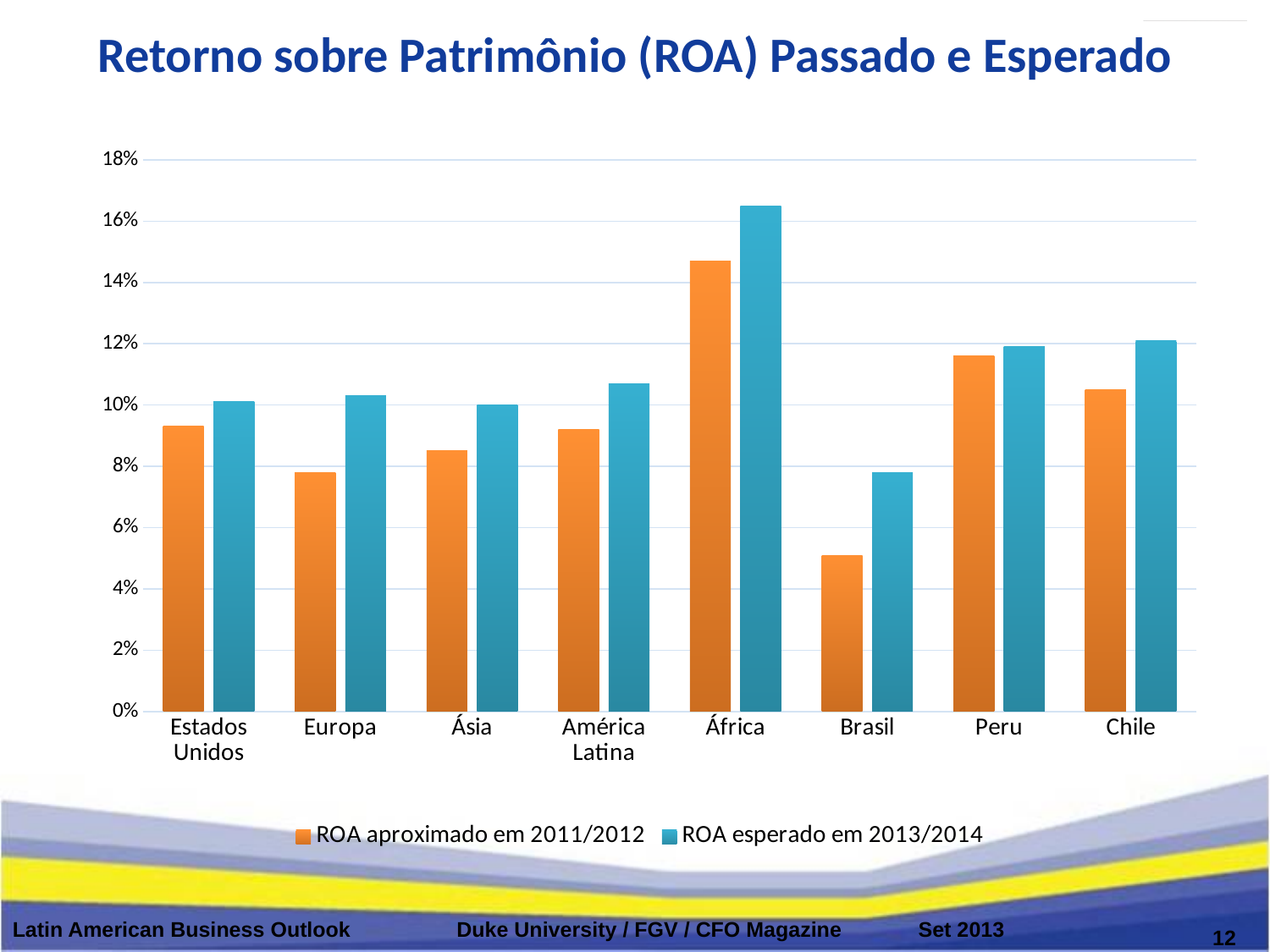
Which region has the lowest value for ROA esperado em 2013/2014? Brasil Is the value for ROA aproximado em 2011/2012 for Peru greater or less than 10%? greater Which region has the highest value for ROA aproximado em 2011/2012? África What kind of chart is shown on the slide? bar chart Which region has the lowest value for ROA aproximado em 2011/2012? Brasil Is the value for ROA esperado em 2013/2014 for África greater or less than 16%? greater Which is larger, the ROA aproximado em 2011/2012 for Peru or for Chile? Peru How many regions/countries are shown on the x axis of the chart? 8 Is the value for ROA aproximado em 2011/2012 for Brasil greater or less than 6%? less What is the title of the chart? Retorno sobre Patrimônio (ROA) Passado e Esperado How many series does the legend list? 2 Which region has the highest value for ROA esperado em 2013/2014? África